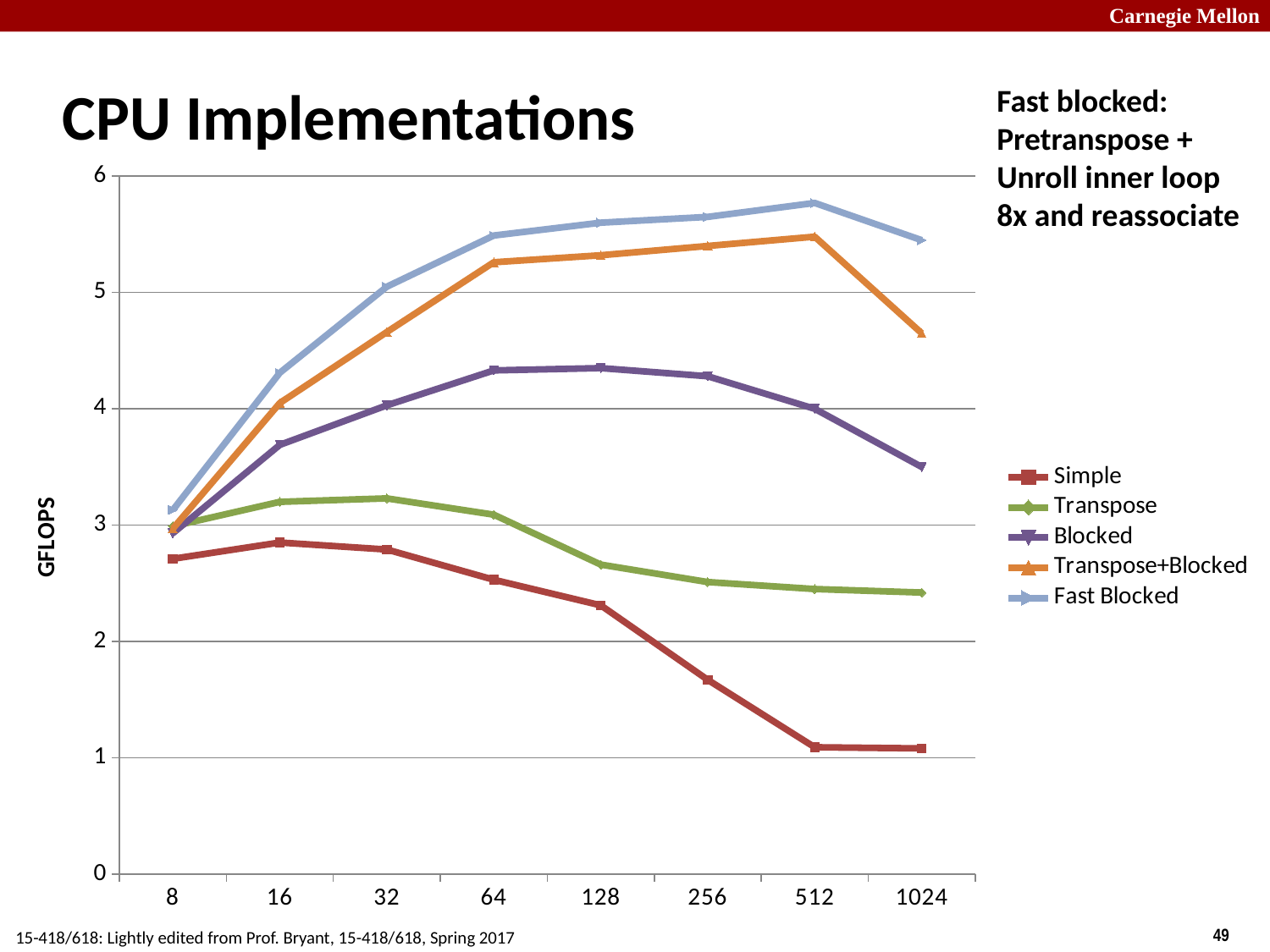
What kind of chart is shown on the slide? line chart Which series is listed last in the legend? Fast Blocked Which series has the lowest value at 256? Simple Is the value for Blocked at 1024 greater or less than 4? less Is the value for Simple at 512 greater or less than 2? less Which series has the highest value at 1024? Fast Blocked What is the label on the y axis? GFLOPS How many series does the legend list? 5 At 64, which is larger: the value for Transpose+Blocked or the value for Blocked? Transpose+Blocked Is the value for Fast Blocked at 512 greater or less than 5? greater How many points are plotted along the x axis for each series? 8 Does the Simple series rise or fall from 128 to 512? fall